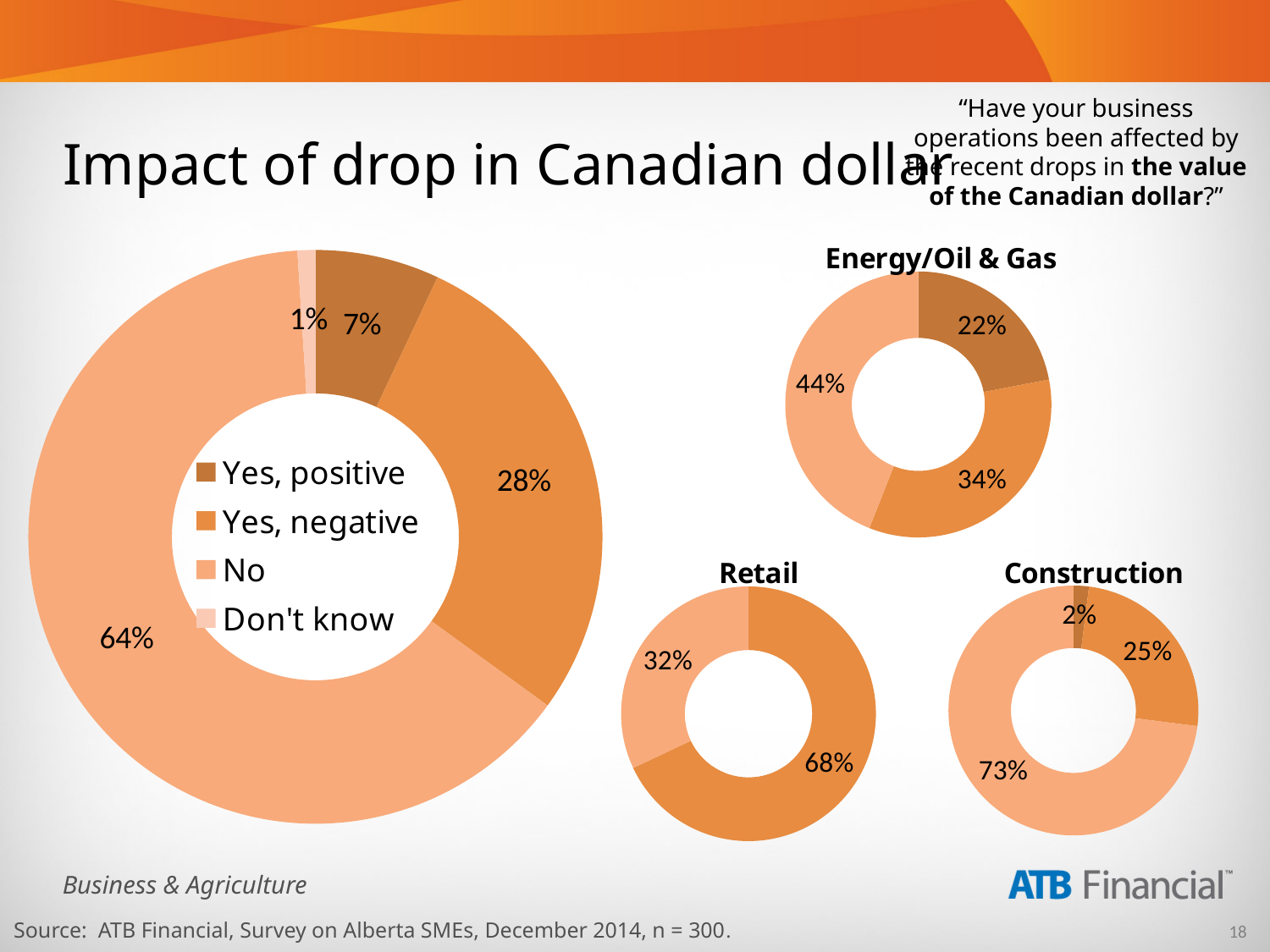
In the Construction chart, what percentage answered "No"? 73% In the Energy/Oil & Gas chart, which response has the largest share? No How many entries does the legend in the large donut chart list? 4 In the large donut chart on the left, which response has the smallest share? Don't know In the large donut chart on the left, what percentage answered "No"? 64% In the Energy/Oil & Gas chart, what percentage answered "Yes, positive"? 22% In the large donut chart on the left, what percentage answered "Yes, negative"? 28% Which is larger: the "Yes, negative" share in the Retail chart or in the Energy/Oil & Gas chart? Retail In the Construction chart, what is the difference between the "No" and "Yes, negative" shares? 48% In the Retail chart, what percentage answered "Yes, negative"? 68% In the Retail chart, how many segments are shown? 2 In the large donut chart on the left, what is the difference between the "Yes, negative" and "Yes, positive" shares? 21%